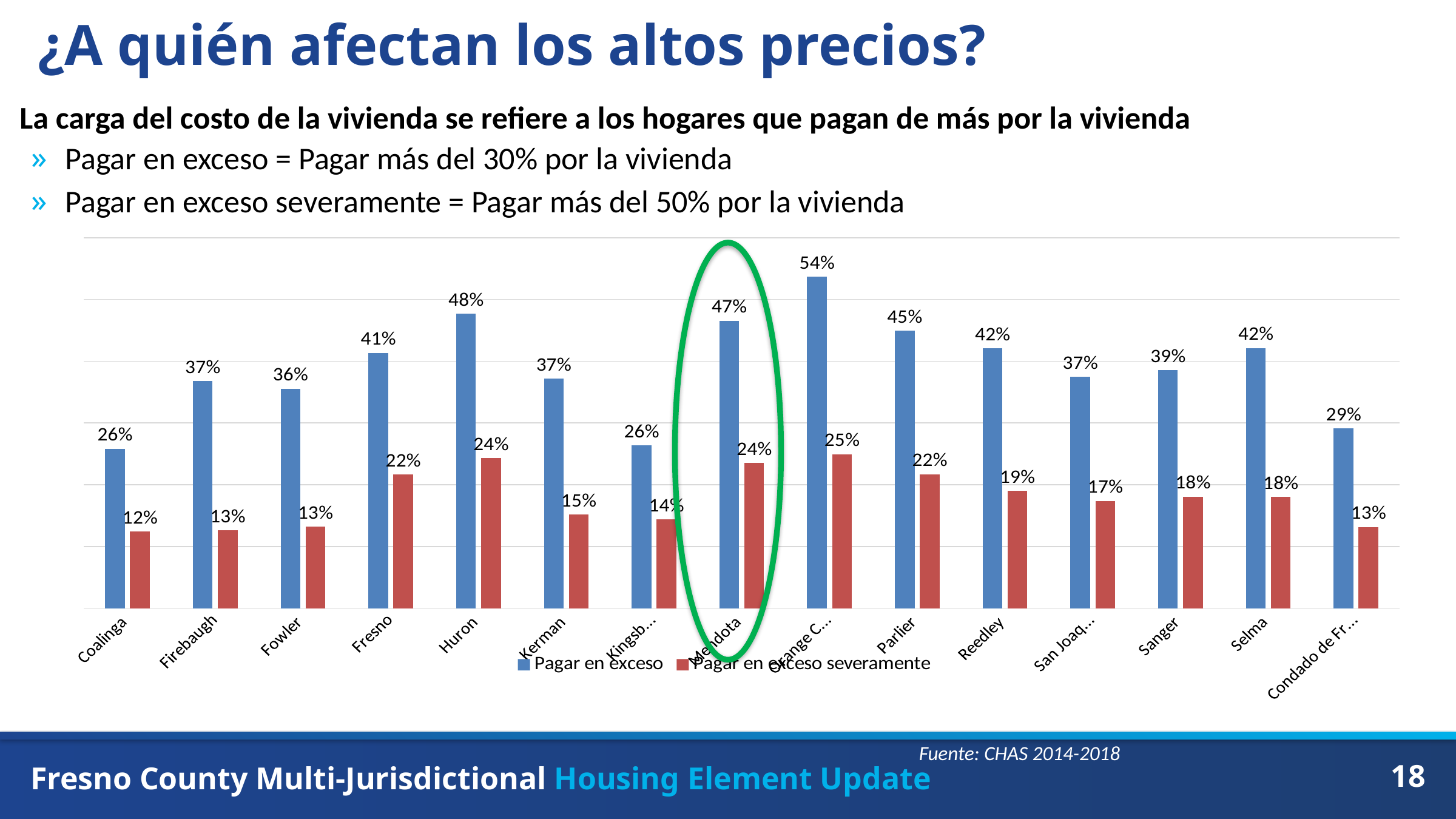
How many categories are shown on the x axis of the chart? 15 Which is larger, the Pagar en exceso severamente value for Huron or for Kerman? Huron What is the value of Pagar en exceso severamente for Fresno? 22% What is the value of Pagar en exceso for Mendota? 47% What is the difference between the Pagar en exceso values for Selma and Sanger? 3% Which is larger, the Pagar en exceso value for Fresno or for Fowler? Fresno How many series does the chart's legend list? 2 Which category has the lowest value for Pagar en exceso severamente? Coalinga What kind of chart is shown on the slide? Bar chart What is the value of Pagar en exceso for Huron? 48% What is the difference between Pagar en exceso and Pagar en exceso severamente for Parlier? 23% What is the value of Pagar en exceso severamente for Reedley? 19%